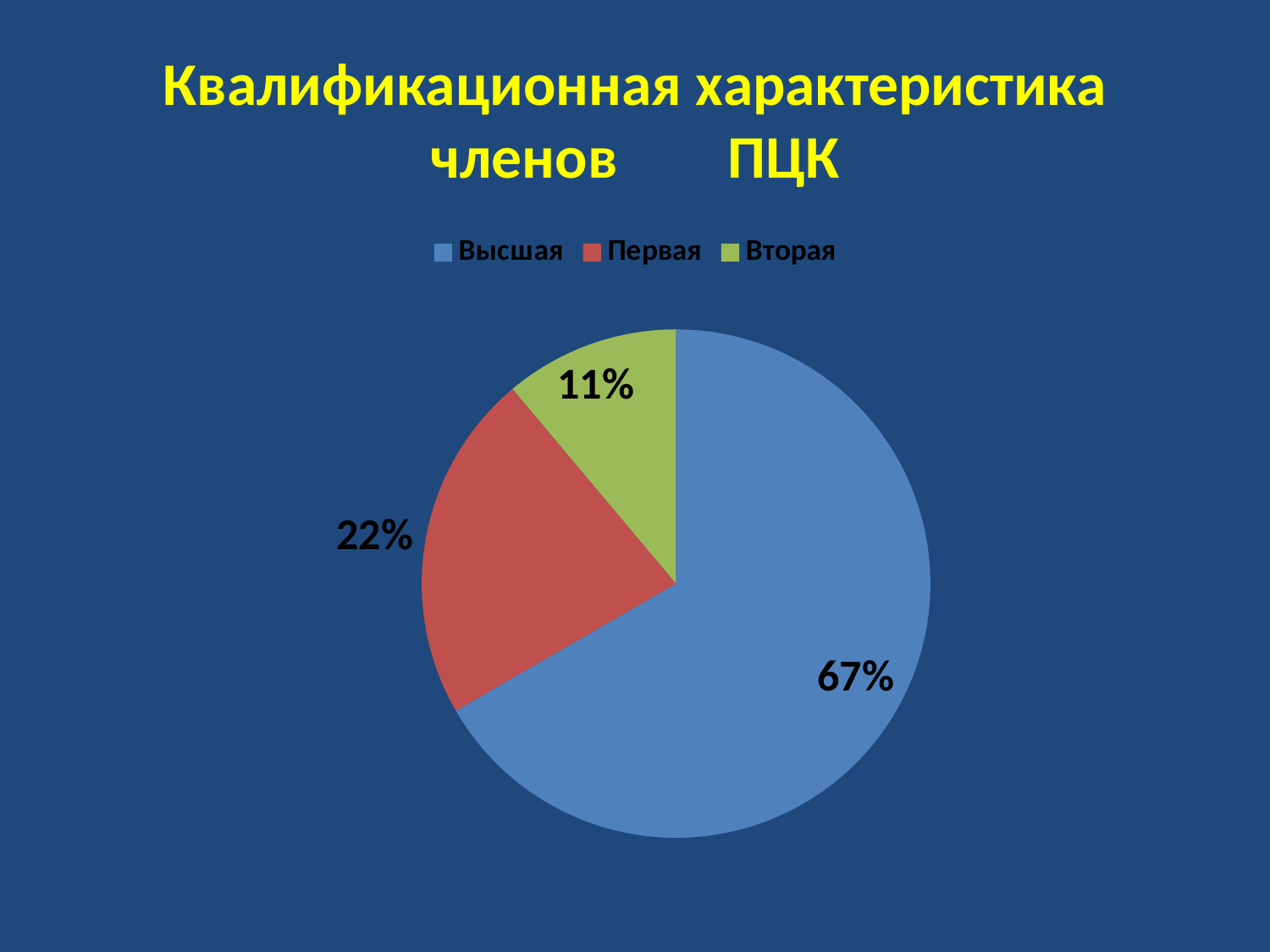
Which is larger, the share for Первая or the share for Вторая? Первая What share of the pie does Высшая have? 67% What share of the pie does Первая have? 22% Which category has the largest slice of the pie? Высшая What share of the pie does Вторая have? 11% How many entries does the legend list? 3 What is the difference in percentage points between Высшая and Первая? 45 How many slices does the pie chart have? 3 What is the difference in percentage points between Первая and Вторая? 11 What colour is the slice for Вторая? green Which category has the smallest slice of the pie? Вторая What kind of chart is shown on the slide? pie chart